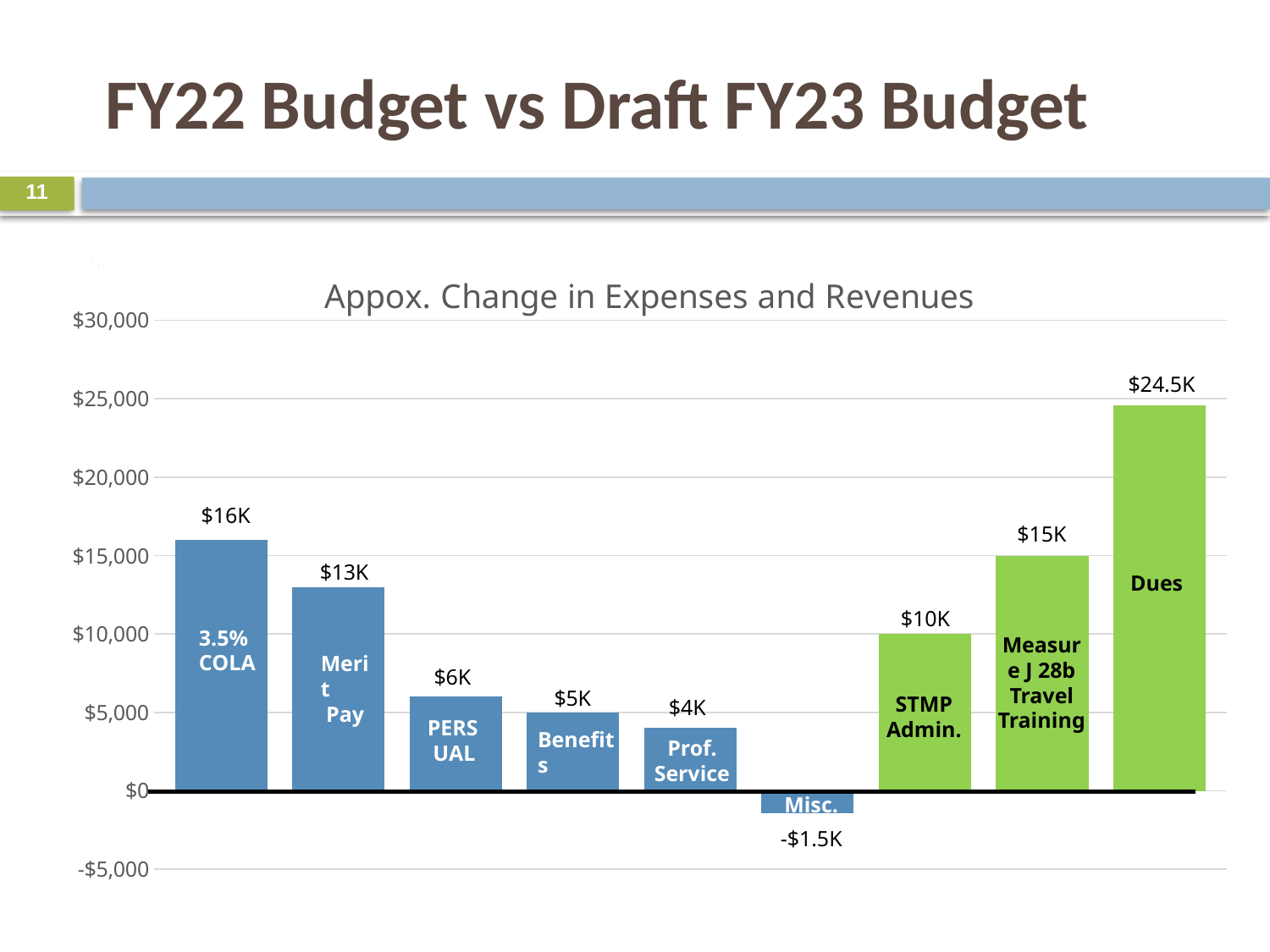
What is the value shown for Misc.? -$1.5K How many categories are plotted in the chart? 9 What is the title of the chart? Appox. Change in Expenses and Revenues Which category has the lowest value? Misc. What is the value shown for 3.5% COLA? $16K What is the value shown for Measure J 28b Travel Training? $15K Is the value for Prof. Service greater or less than $5,000? less What is the difference between the values for Dues and 3.5% COLA? $8.5K What is the difference between the values for Merit Pay and PERS UAL? $7K Which category has the highest value? Dues What is the value shown for Merit Pay? $13K Which is larger, the value for STMP Admin. or the value for Benefits? STMP Admin.